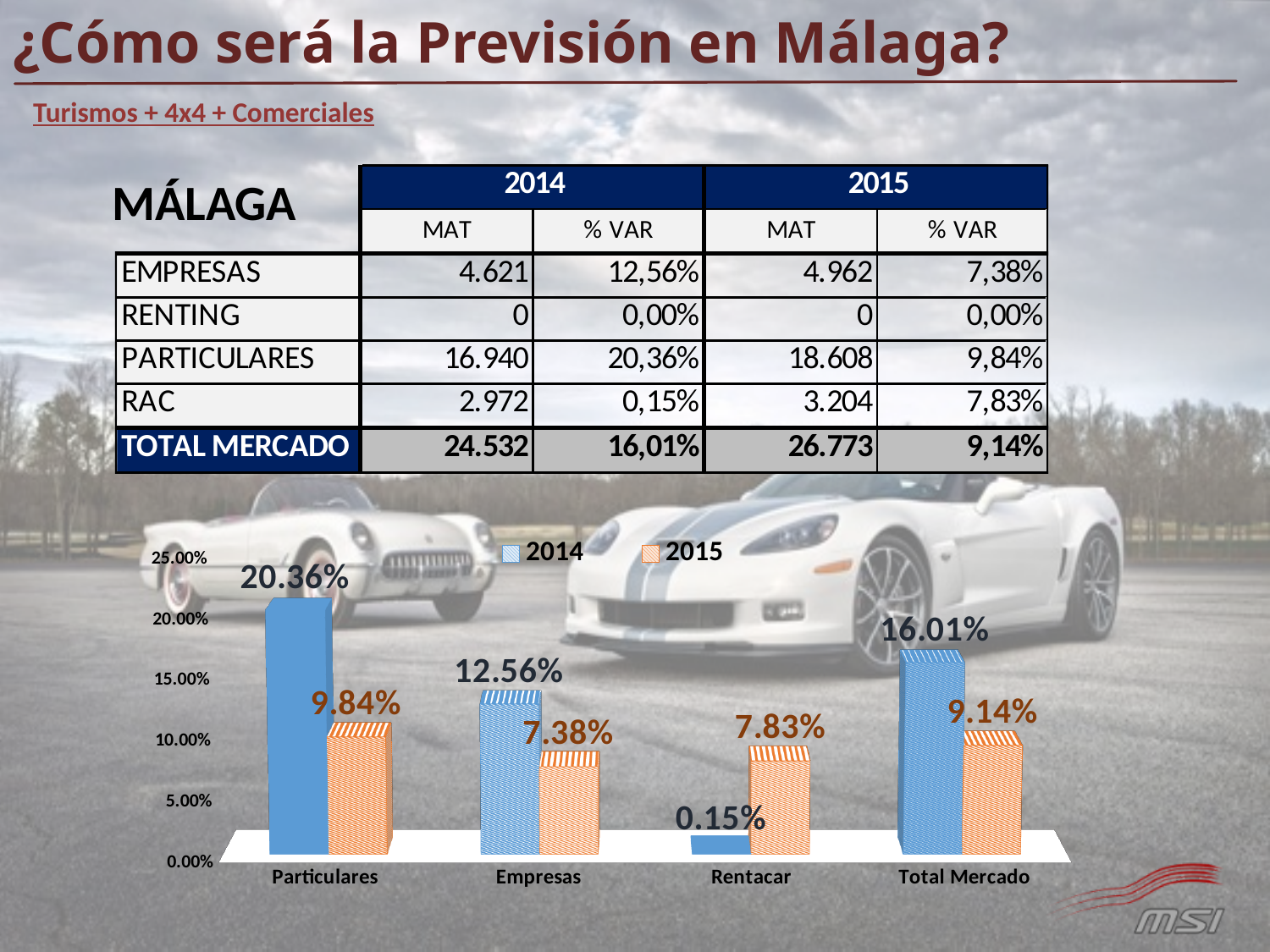
What is the 2015 value for Total Mercado in the bar chart? 9.14% In the bar chart, which is larger for Rentacar: the 2014 value or the 2015 value? 2015 What type of chart is shown at the bottom of the slide? Bar chart What is the 2015 value for Empresas in the bar chart? 7.38% How many series does the legend of the bar chart list? 2 What is the 2014 value for Particulares in the bar chart? 20.36% Which category has the lowest 2015 value in the bar chart? Empresas How many categories are shown on the x axis of the bar chart? 4 Which category has the lowest 2014 value in the bar chart? Rentacar Which category has the highest 2014 value in the bar chart? Particulares What is the difference between the 2014 and 2015 values for Particulares in the bar chart? 10.52% What is the 2014 value for Rentacar in the bar chart? 0.15%